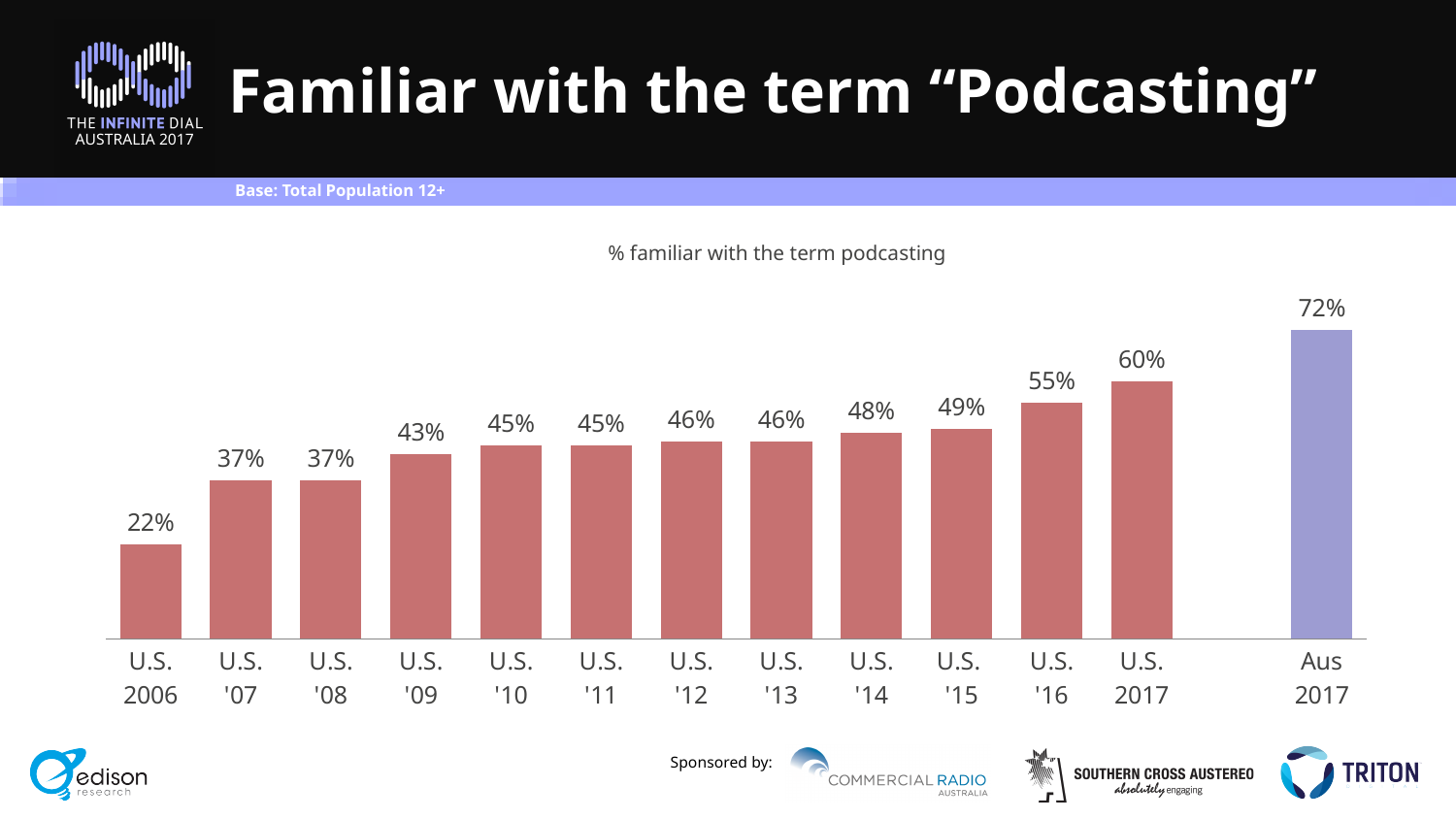
What is the value for U.S. '14? 48% What kind of chart is shown on the slide? Bar chart Which category has the lowest value? U.S. 2006 What is the difference between U.S. '16 and U.S. '15? 6% How many bars are shown in the chart? 13 Which is larger, the value for U.S. '09 or U.S. '07? U.S. '09 Which category has the highest value? Aus 2017 What is the value for Aus 2017? 72% What is the difference between Aus 2017 and U.S. 2017? 12% Do the U.S. values generally rise or fall from 2006 to 2017? Rise What is the value for U.S. 2017? 60% What is the value for U.S. 2006? 22%